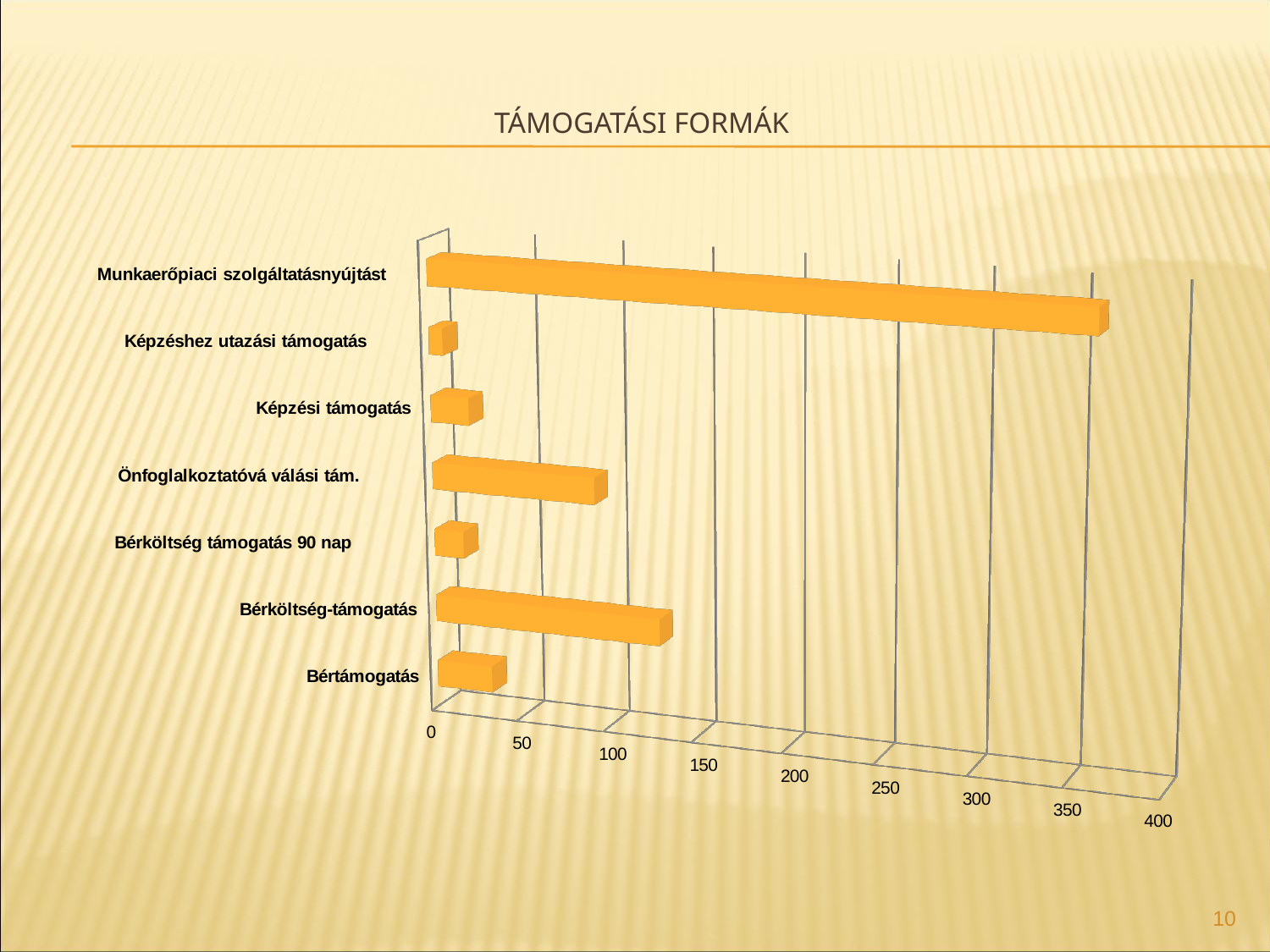
Is the value for Képzéshez utazási támogatás greater or less than 50? less What is the highest value shown on the horizontal axis of the chart? 400 What is the title of the chart on the slide? TÁMOGATÁSI FORMÁK Which is larger, the value for Bérköltség-támogatás or the value for Önfoglalkoztatóvá válási tám.? Bérköltség-támogatás What kind of chart is shown on the slide? bar chart Which category has the highest value in the chart? Munkaerőpiaci szolgáltatásnyújtást Is the value for Bérköltség támogatás 90 nap greater or less than 50? less How many categories are plotted in the chart? 7 Which category has the lowest value in the chart? Képzéshez utazási támogatás Is the value for Önfoglalkoztatóvá válási tám. greater or less than 50? greater